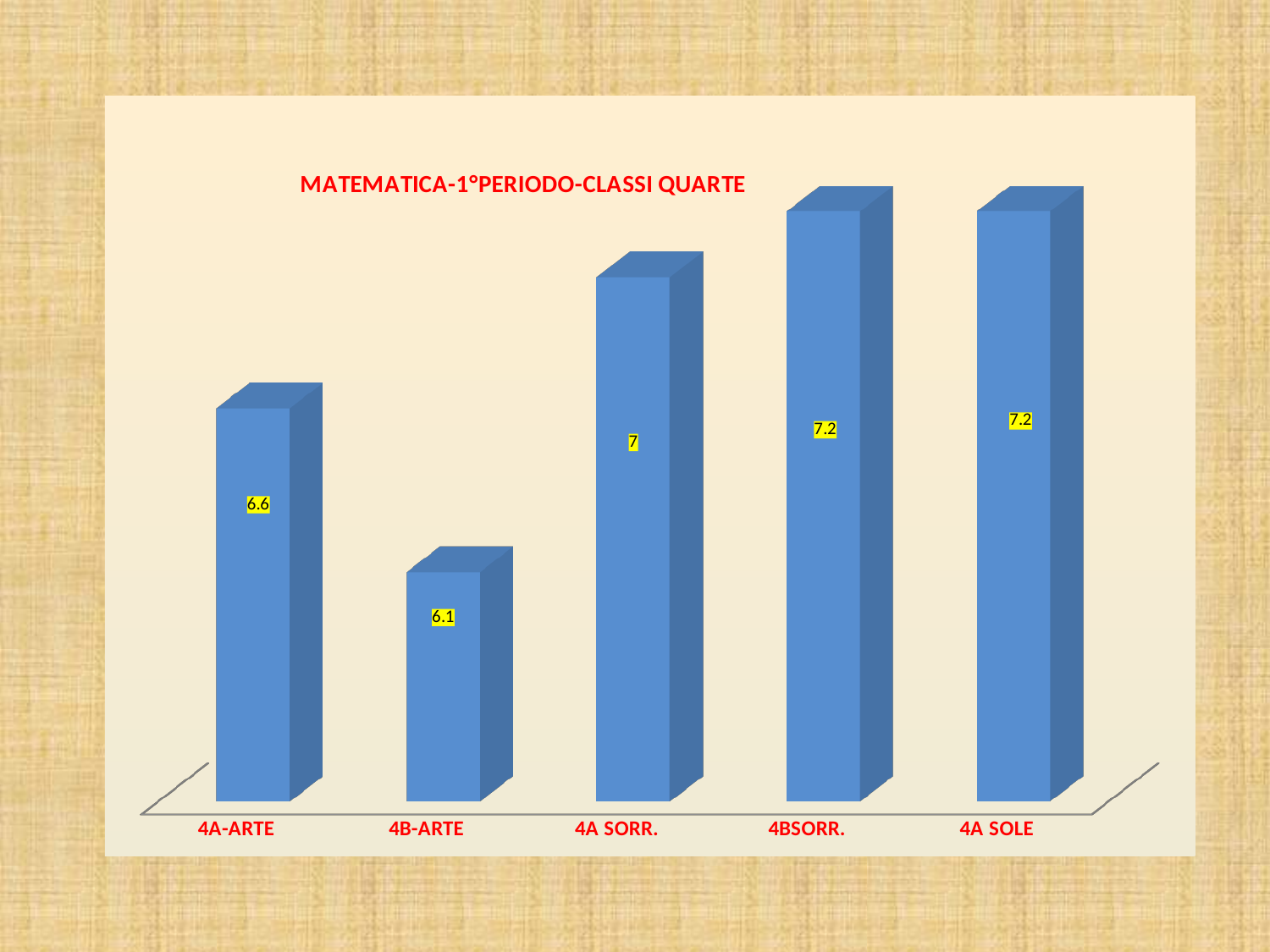
What kind of chart is shown on the slide? Bar chart What is the value for 4A SOLE? 7.2 How many categories are shown in the chart? 5 What is the value for 4B-ARTE? 6.1 Which is larger, the value for 4A SORR. or the value for 4A-ARTE? 4A SORR. Which category has the lowest value? 4B-ARTE What is the difference between the values for 4BSORR. and 4A SORR.? 0.2 What is the value for 4BSORR.? 7.2 What is the difference between the values for 4A-ARTE and 4B-ARTE? 0.5 What is the title of the chart? MATEMATICA-1°PERIODO-CLASSI QUARTE What is the value for 4A SORR.? 7 What is the value for 4A-ARTE? 6.6